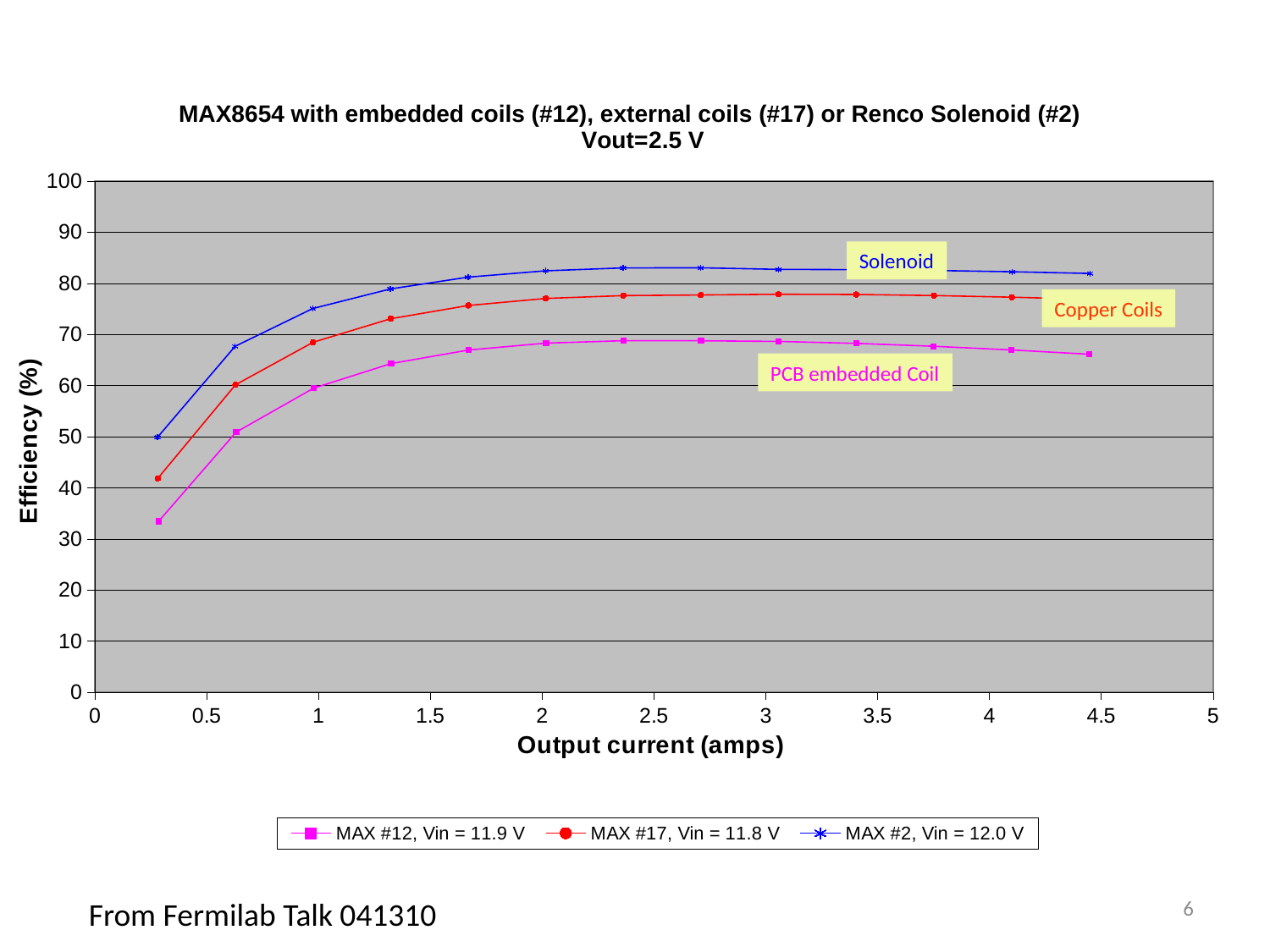
What is the title of the chart? MAX8654 with embedded coils (#12), external coils (#17) or Renco Solenoid (#2) Vout=2.5 V Is the efficiency of MAX #2, Vin = 12.0 V at about 2.5 amps greater or less than 80? greater Is the efficiency of MAX #12, Vin = 11.9 V at about 4.5 amps greater or less than 70? less Is the efficiency of MAX #17, Vin = 11.8 V at about 2.5 amps greater or less than 80? less How many series does the legend list? 3 Does the efficiency of each series rise or fall as output current increases from 0 to 2 amps? rise Which series has the highest efficiency across the plotted output currents? MAX #2, Vin = 12.0 V At about 1 amp, which series has the higher efficiency: MAX #17, Vin = 11.8 V or MAX #12, Vin = 11.9 V? MAX #17, Vin = 11.8 V Which annotation label is placed next to the blue line? Solenoid What kind of chart is shown on the slide? line chart Which series has the lowest efficiency across the plotted output currents? MAX #12, Vin = 11.9 V